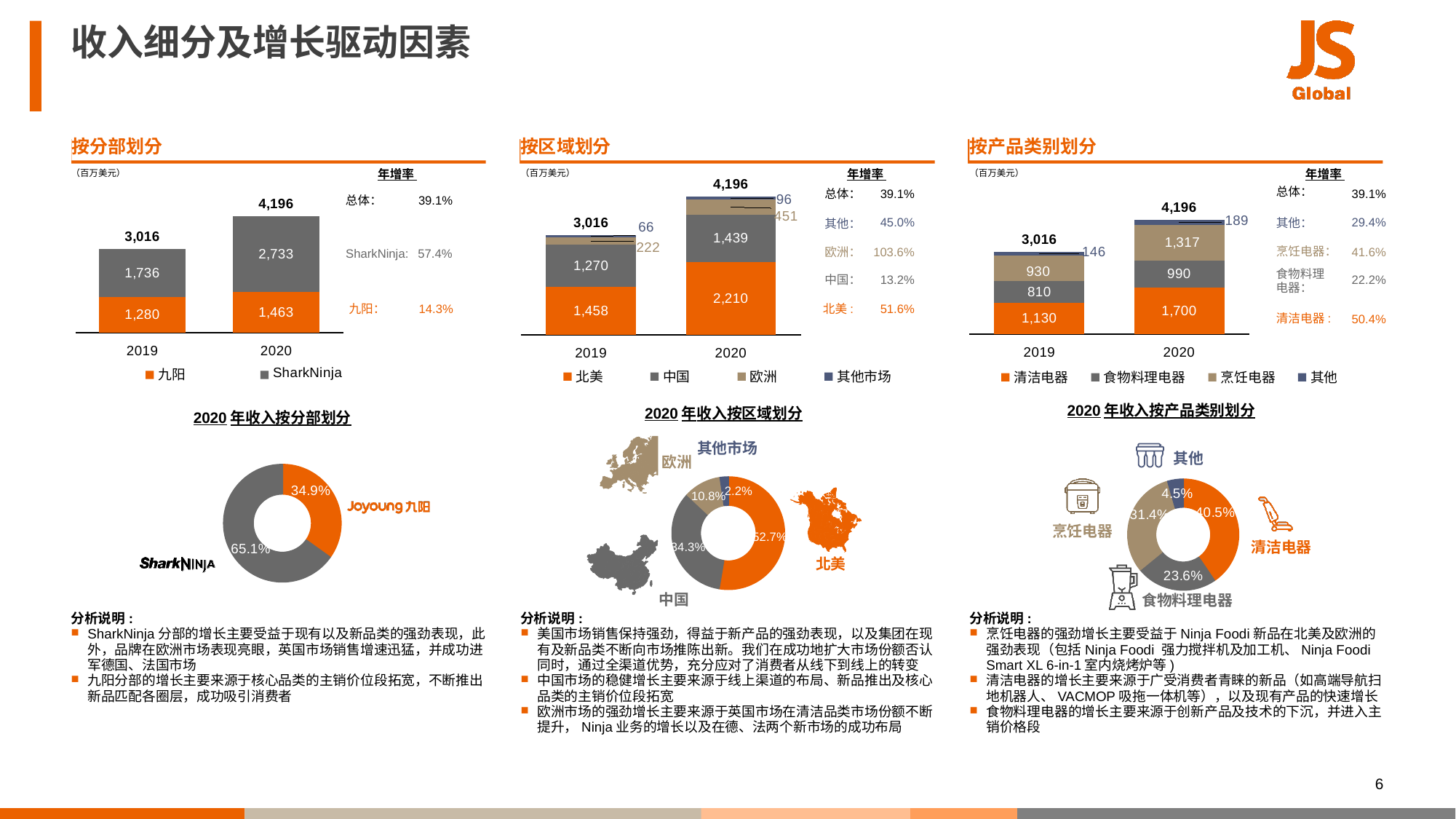
In the 按分部划分 bar chart, what is the value for SharkNinja in 2020? 2,733 In the 2020 年收入按区域划分 donut chart, what share does 欧洲 have? 10.8% In the 按分部划分 bar chart, what is the total of the stacked bar for 2019? 3,016 In the 按区域划分 bar chart, how many series does the legend list? 4 What kind of chart is the 2020 年收入按分部划分 chart? Donut (pie) chart In the 按区域划分 bar chart, what is the value for 中国 in 2020? 1,439 In the 按分部划分 bar chart, what is the difference between the 九阳 values for 2020 and 2019? 183 In the 按区域划分 bar chart, which region has the lowest value in 2019? 其他市场 In the 按产品类别划分 bar chart, what is the value for 烹饪电器 in 2019? 930 In the 2020 年收入按分部划分 donut chart, what share does SharkNinja have? 65.1% In the 2020 年收入按产品类别划分 donut chart, which category has the largest share? 清洁电器 In the 按产品类别划分 bar chart, which is larger in 2020: 食物料理电器 or 烹饪电器? 烹饪电器